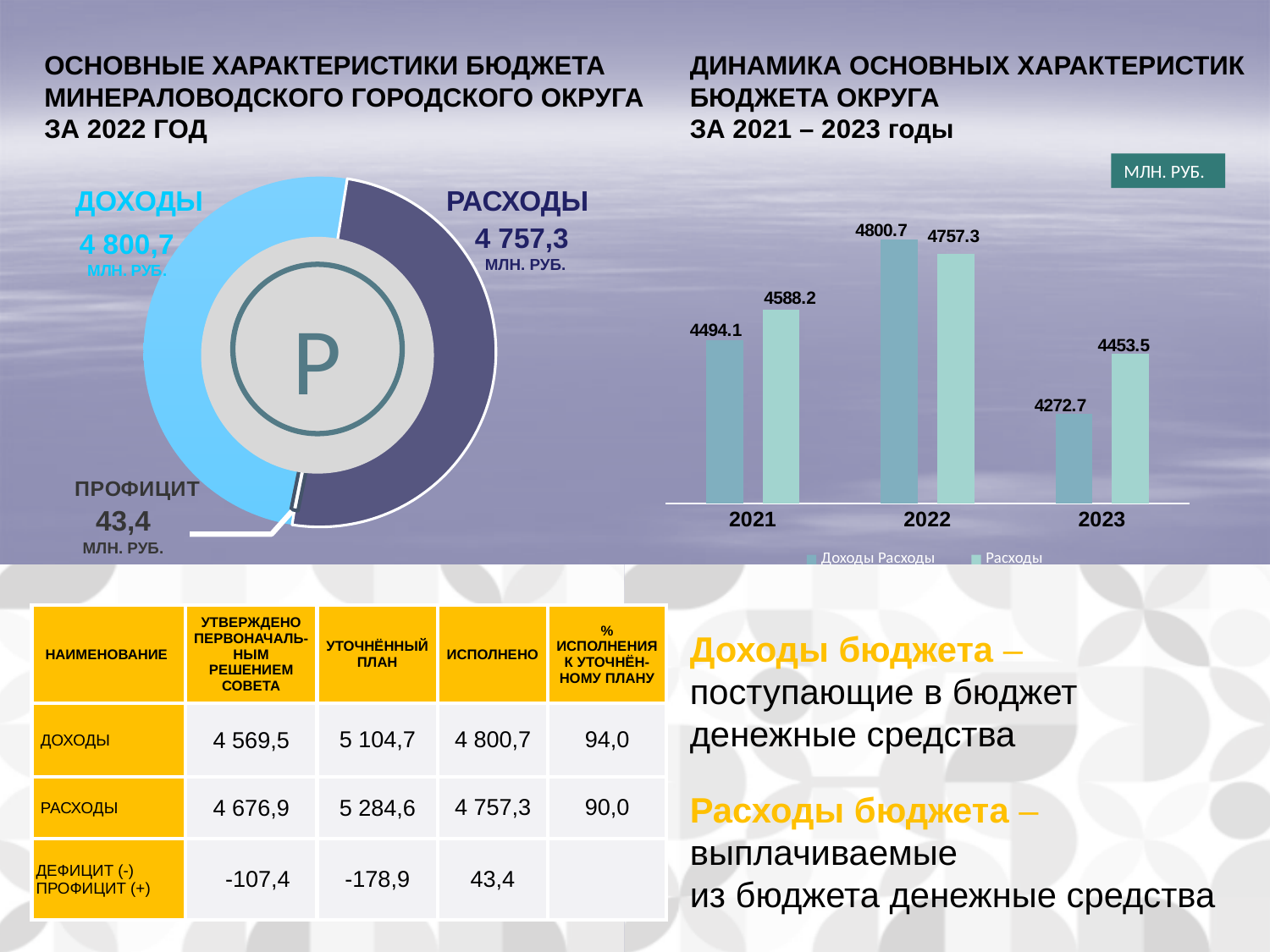
In the bar chart on the right, which is larger in 2023: Доходы or Расходы? Расходы In the bar chart on the right, what is the value of Расходы for 2023? 4453.5 In the bar chart on the right, which year has the lowest Расходы value? 2023 In the bar chart on the right, what is the value of Доходы for 2021? 4494.1 In the bar chart on the right, what is the difference between Расходы and Доходы in 2021? 94.1 In the donut chart on the left ('ОСНОВНЫЕ ХАРАКТЕРИСТИКИ БЮДЖЕТА МИНЕРАЛОВОДСКОГО ГОРОДСКОГО ОКРУГА ЗА 2022 ГОД'), what is the value shown for ДОХОДЫ? 4 800,7 МЛН. РУБ. What kind of chart is shown on the right side of the slide under 'ДИНАМИКА ОСНОВНЫХ ХАРАКТЕРИСТИК БЮДЖЕТА ОКРУГА'? bar chart In the bar chart on the right, how many years are shown on the x axis? 3 In the bar chart on the right, which year has the highest Доходы value? 2022 In the donut chart on the left, what is the value shown for ПРОФИЦИТ? 43,4 МЛН. РУБ. In the bar chart on the right, how many series does the legend list? 2 In the bar chart 'ДИНАМИКА ОСНОВНЫХ ХАРАКТЕРИСТИК БЮДЖЕТА ОКРУГА ЗА 2021 – 2023 годы', what is the value of Доходы for 2022? 4800.7